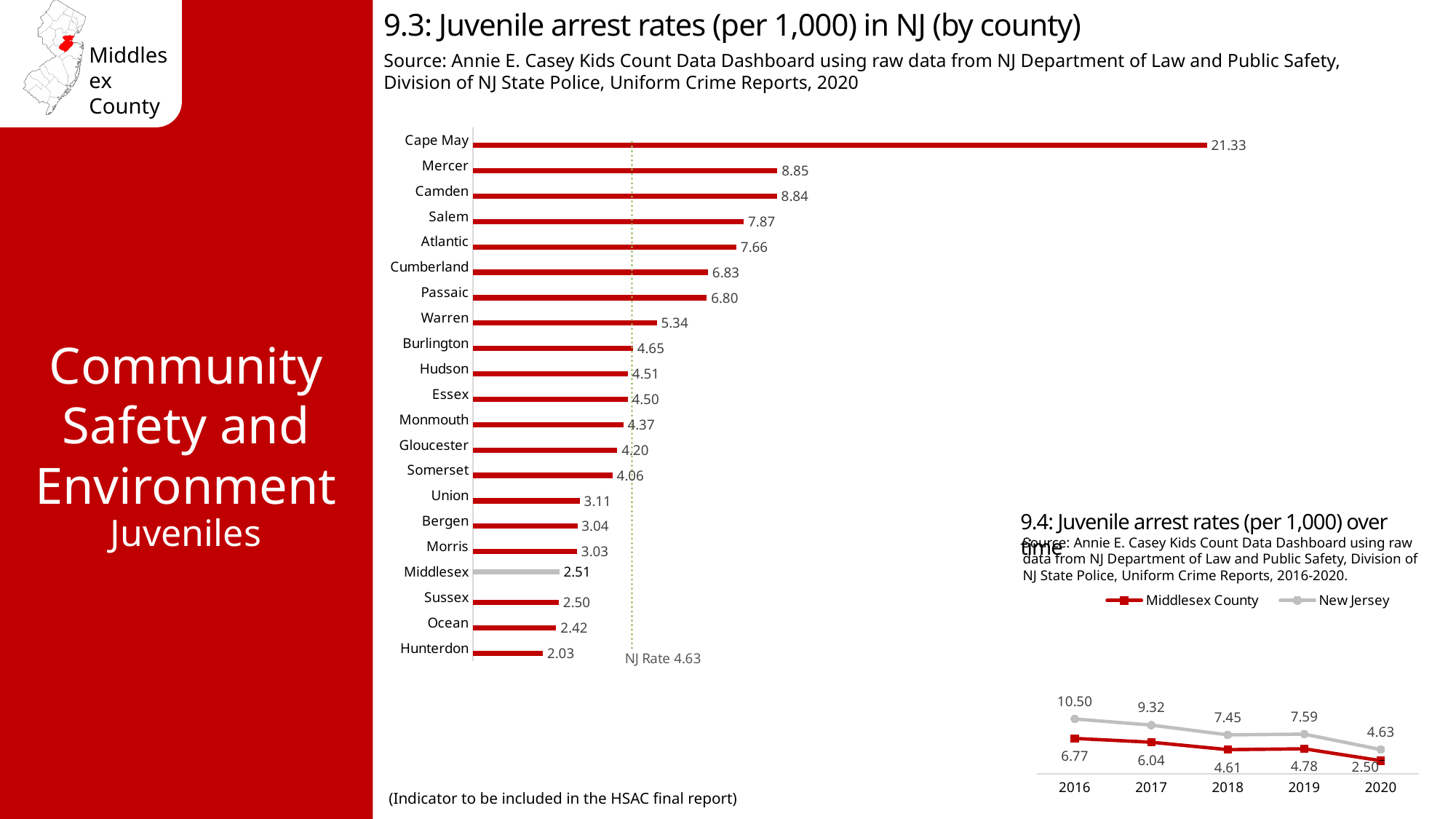
What kind of chart is '9.3: Juvenile arrest rates (per 1,000) in NJ (by county)'? Bar chart In the chart '9.3: Juvenile arrest rates (per 1,000) in NJ (by county)', which has a higher rate, Salem or Atlantic? Salem In the chart '9.4: Juvenile arrest rates (per 1,000) over time', what is the value for Middlesex County in 2018? 4.61 In the chart '9.4: Juvenile arrest rates (per 1,000) over time', how many series does the legend list? 2 In the chart '9.3: Juvenile arrest rates (per 1,000) in NJ (by county)', what NJ rate is marked by the dotted reference line? 4.63 In the chart '9.3: Juvenile arrest rates (per 1,000) in NJ (by county)', what is the difference between the values for Cape May and Mercer? 12.48 In the chart '9.3: Juvenile arrest rates (per 1,000) in NJ (by county)', what is the value for Middlesex? 2.51 In the chart '9.3: Juvenile arrest rates (per 1,000) in NJ (by county)', which county has the highest rate? Cape May In the chart '9.4: Juvenile arrest rates (per 1,000) over time', what is the difference between the New Jersey and Middlesex County values in 2016? 3.73 In the chart '9.3: Juvenile arrest rates (per 1,000) in NJ (by county)', which county has the lowest rate? Hunterdon In the chart '9.3: Juvenile arrest rates (per 1,000) in NJ (by county)', how many counties are shown? 21 In the chart '9.4: Juvenile arrest rates (per 1,000) over time', does the New Jersey rate generally rise or fall from 2016 to 2020? Fall